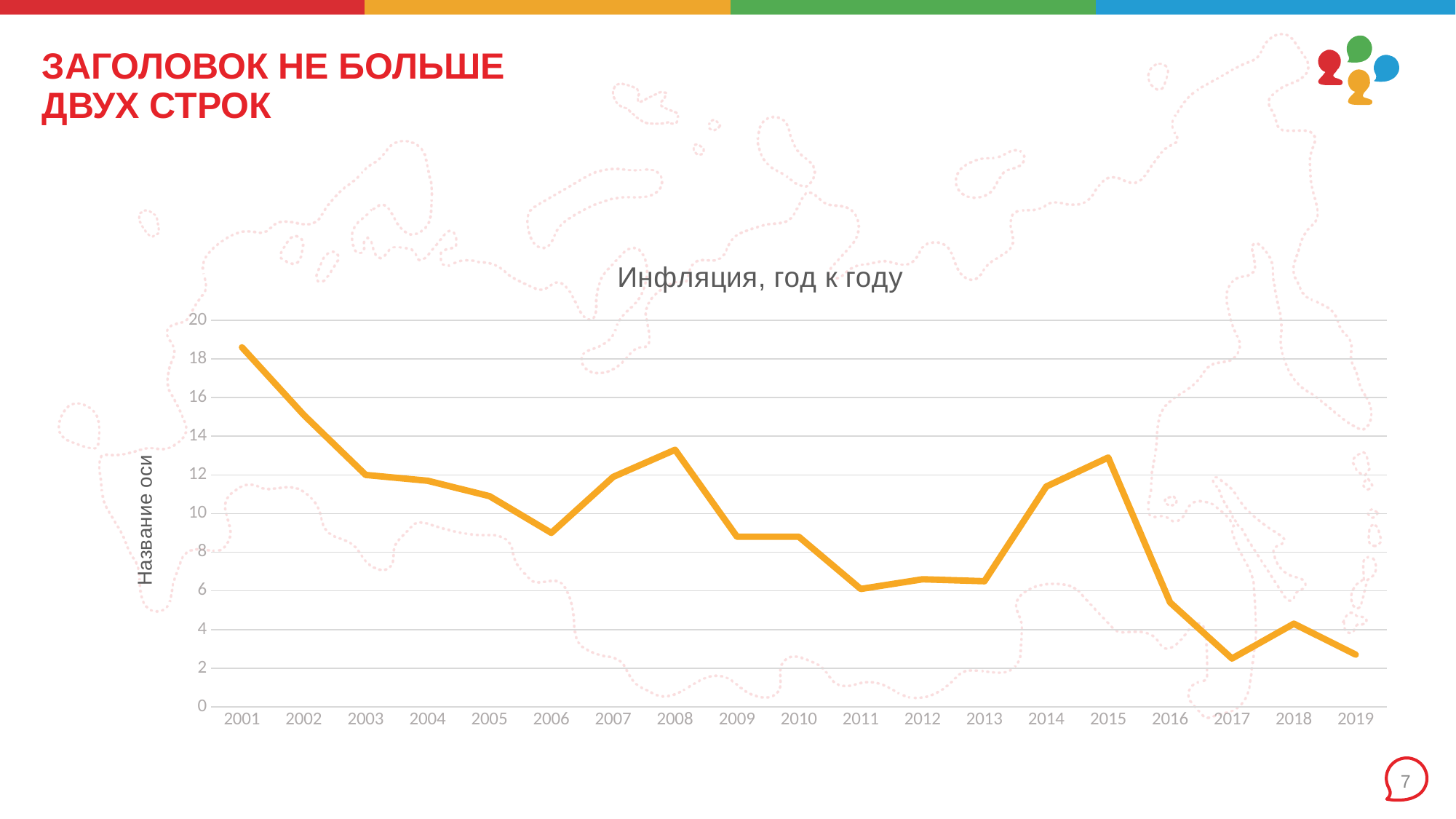
Is the value for 2017 greater or less than 4? less What kind of chart is shown on the slide? Line chart Is the value for 2008 greater or less than 12? greater What is the label on the vertical axis of the chart? Название оси How many years are plotted along the x axis of the chart? 19 Is the value for 2001 greater or less than 18? greater Overall, do the values rise or fall from 2001 to 2019? fall Which is larger, the value for 2014 or the value for 2015? 2015 Which year has the highest value on the chart? 2001 What is the title of the chart? Инфляция, год к году Which is larger, the value for 2007 or the value for 2008? 2008